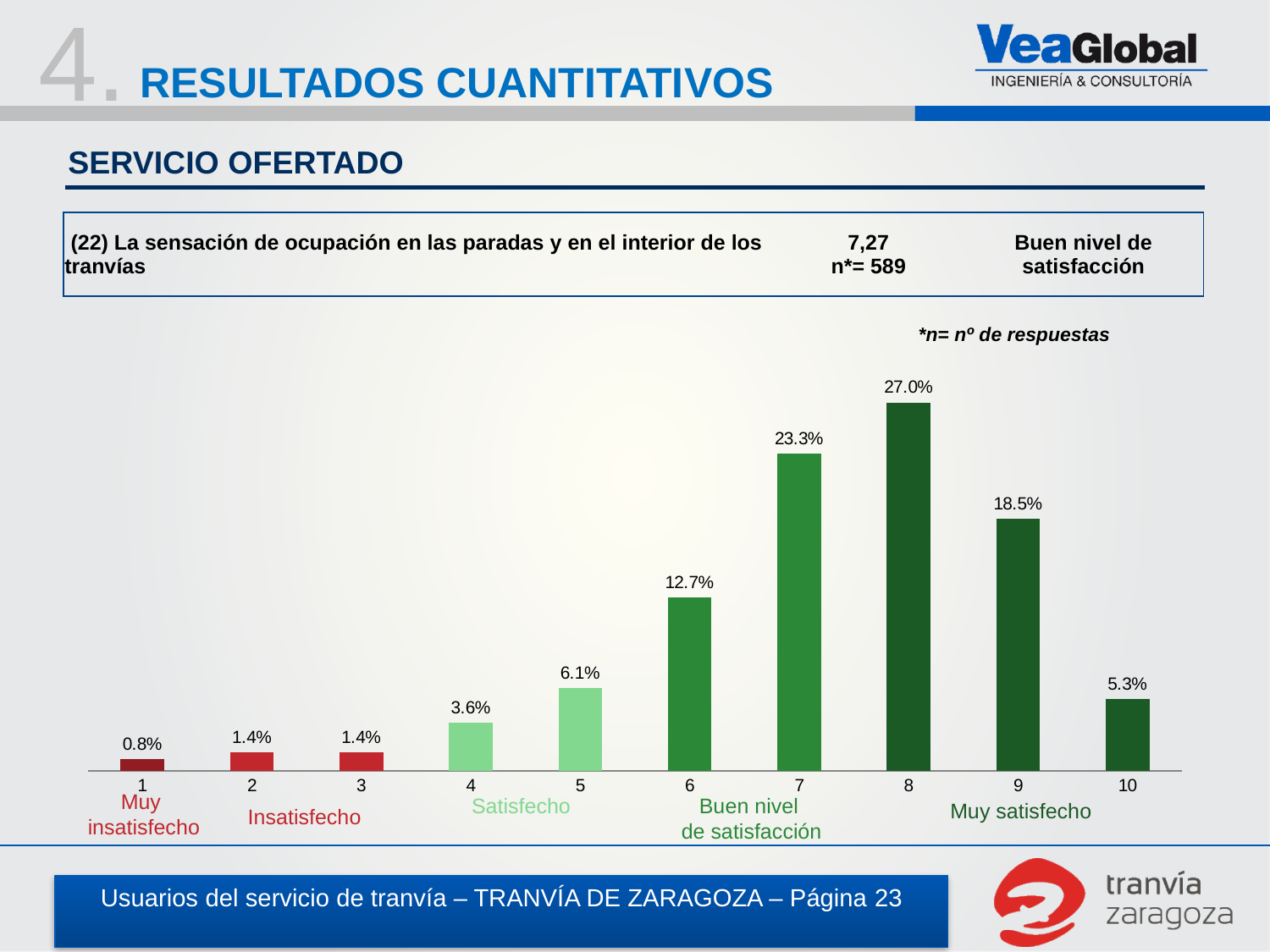
What kind of chart is shown on the slide? Bar chart Which score has the lowest percentage of responses? 1 Do the values rise or fall from score 1 to score 8? Rise What is the value shown for score 6? 12.7% Which has a larger value, score 5 or score 6? 6 What is the difference between the values for score 9 and score 10? 13.2% What is the combined value of scores 2 and 3? 2.8% What is the difference between the values for score 8 and score 7? 3.7% How many score categories are shown on the x axis? 10 Which score has the highest percentage of responses? 8 What is the value shown for score 10? 5.3% What percentage of respondents gave a score of 8? 27.0%